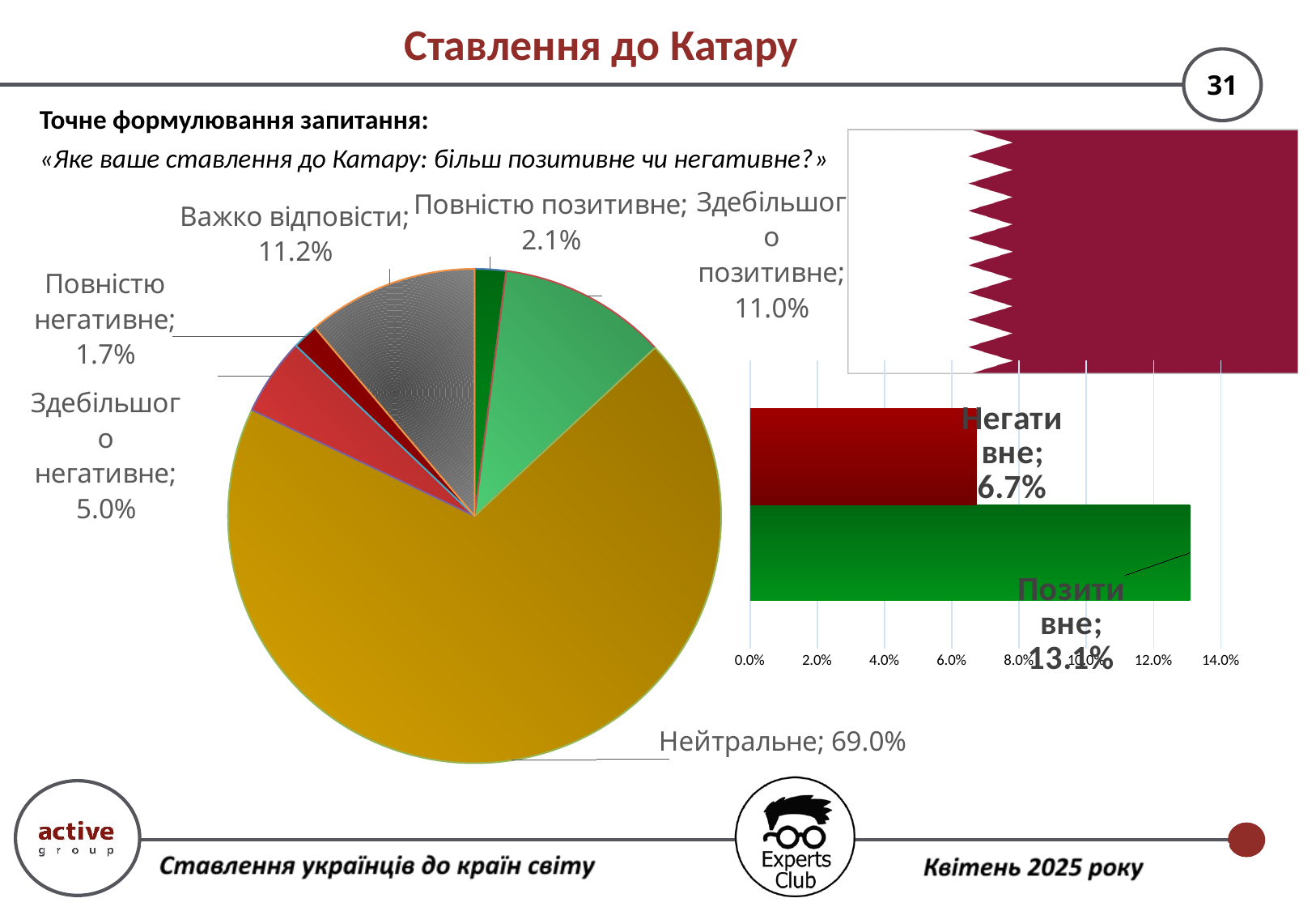
In the pie chart on the left, what share is labelled for Нейтральне? 69.0% In the pie chart on the left, which is larger: Повністю позитивне or Здебільшого негативне? Здебільшого негативне In the pie chart on the left, what is the value for Здебільшого позитивне? 11.0% What kind of chart is shown on the right side of the slide? Bar chart In the bar chart on the right, what is the value for Негативне? 6.7% In the pie chart on the left, which category has the smallest slice? Повністю негативне In the bar chart on the right, what is the difference between Позитивне and Негативне? 6.4% In the pie chart on the left, what is the difference between Здебільшого негативне and Повністю негативне? 3.3% In the bar chart on the right, what is the value for Позитивне? 13.1% In the pie chart on the left, what is the value for Важко відповісти? 11.2% In the pie chart on the left, which category has the largest slice? Нейтральне In the pie chart on the left, how many categories are shown? 6